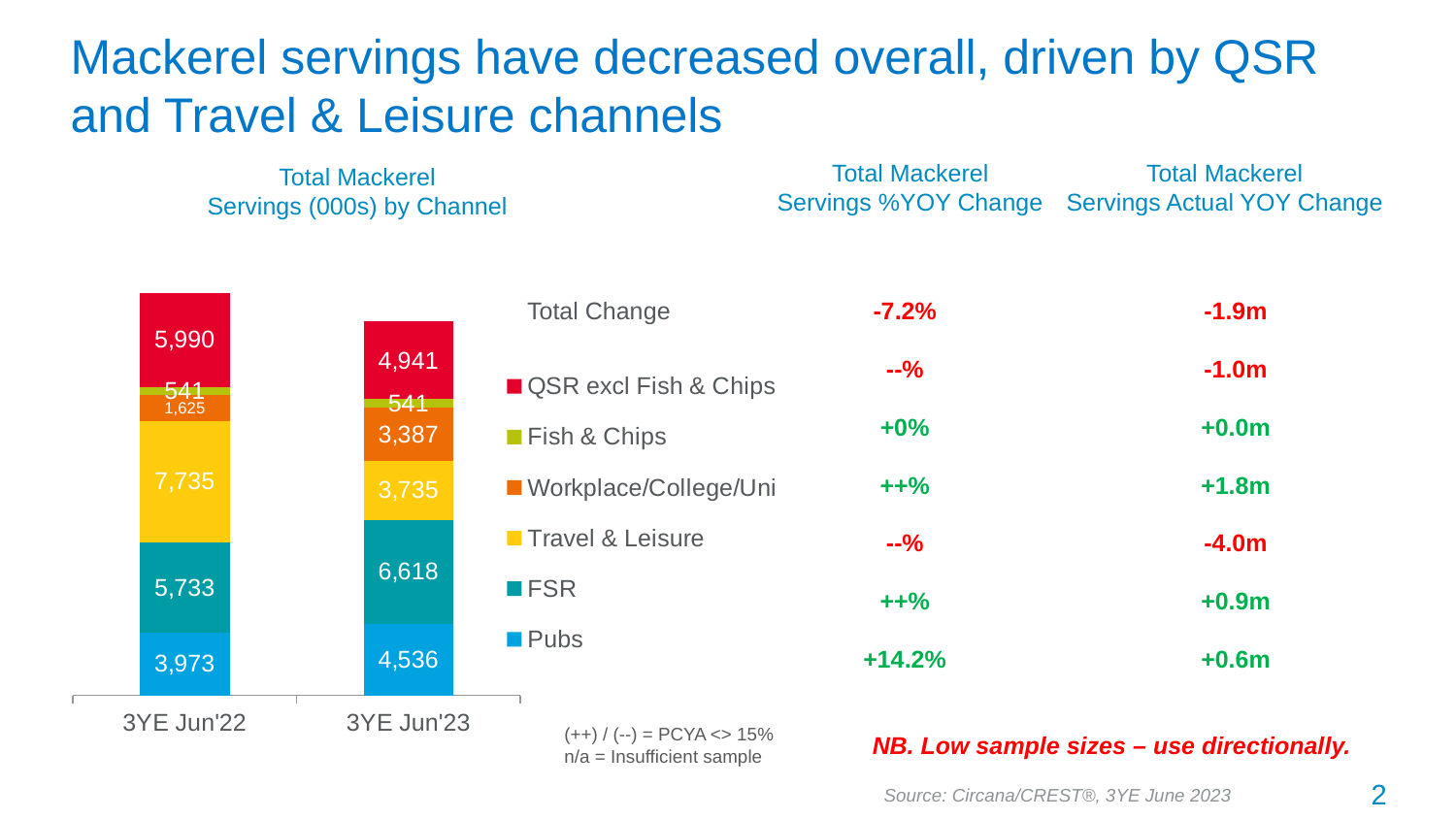
What is the total of the 3YE Jun'23 stacked bar? 23,758 How many series does the chart legend list? 6 What is the value for Travel & Leisure in 3YE Jun'22? 7,735 Does the Travel & Leisure value rise or fall from 3YE Jun'22 to 3YE Jun'23? Fall Which channel has the smallest segment in the 3YE Jun'23 bar? Fish & Chips Which is larger: Workplace/College/Uni in 3YE Jun'22 or in 3YE Jun'23? 3YE Jun'23 What is the value for QSR excl Fish & Chips in 3YE Jun'23? 4,941 What kind of chart is shown on the slide? Stacked bar chart What is the value for Pubs in 3YE Jun'23? 4,536 How many bars (time periods) are plotted on the chart? 2 Which channel has the largest segment in the 3YE Jun'22 bar? Travel & Leisure By how much did the FSR value change from 3YE Jun'22 to 3YE Jun'23? 885